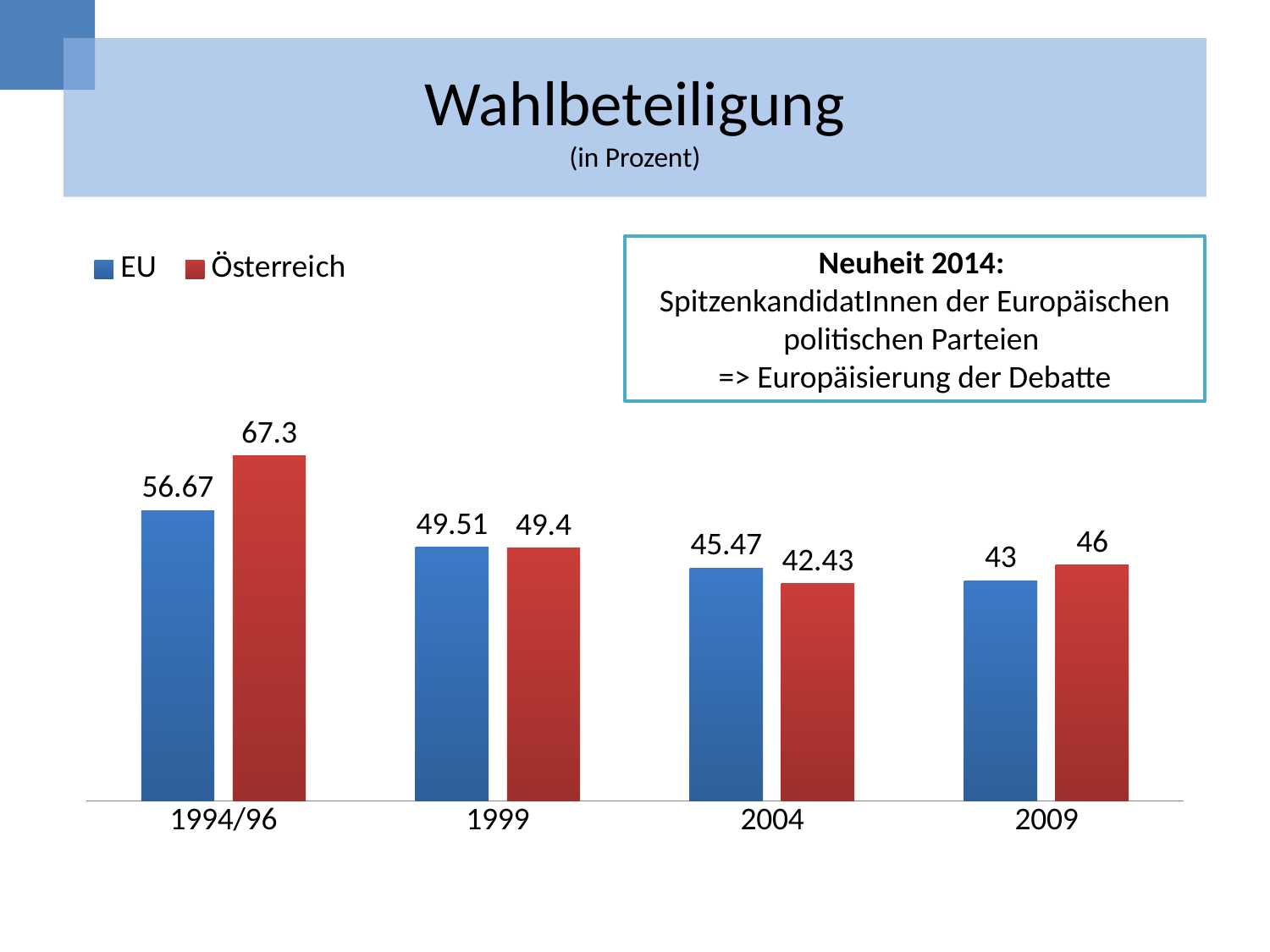
Do the EU values rise or fall from 1994/96 to 2009? fall What is the EU value for 1994/96? 56.67 What is the Österreich value for 2004? 42.43 How many series does the legend list? 2 Which is larger in 2009, the EU value or the Österreich value? Österreich What is the Österreich value for 2009? 46 What is the difference between the Österreich and EU values for 1994/96? 10.63 What is the difference between the EU and Österreich values for 2004? 3.04 Which category has the lowest EU value? 2009 What kind of chart is shown on the slide? bar chart How many categories are shown on the x axis? 4 Which category has the highest Österreich value? 1994/96